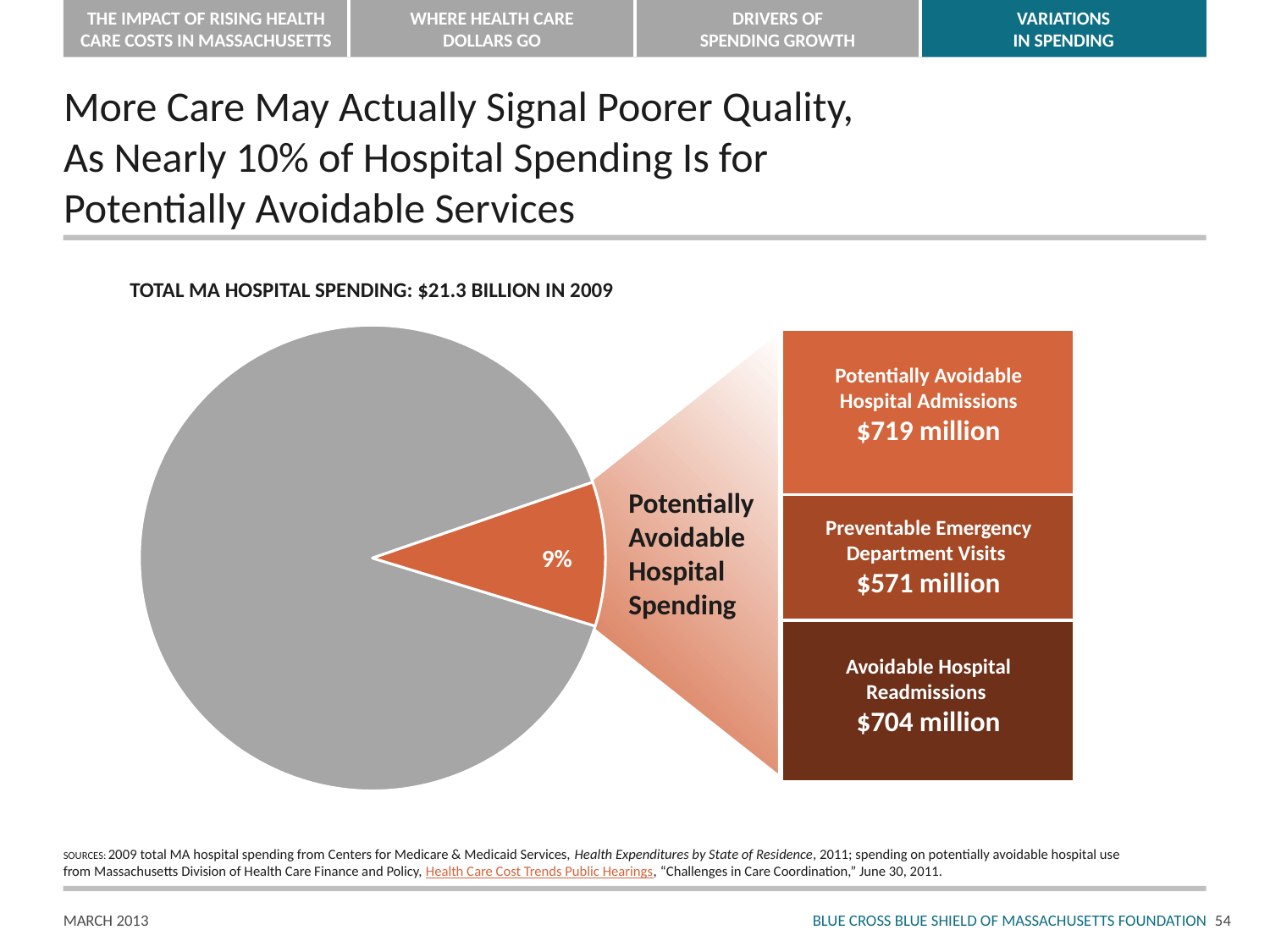
What is the value shown for Potentially Avoidable Hospital Admissions? $719 million What total MA hospital spending figure is stated in the chart heading? $21.3 billion in 2009 What is the value shown for Avoidable Hospital Readmissions? $704 million What is the value shown for Preventable Emergency Department Visits? $571 million What is the combined value of the three potentially avoidable hospital spending components? $1,994 million Which of the three components of potentially avoidable hospital spending has the highest value? Potentially Avoidable Hospital Admissions How many components of potentially avoidable hospital spending are broken out next to the pie chart? 3 Which is larger: Avoidable Hospital Readmissions or Preventable Emergency Department Visits? Avoidable Hospital Readmissions What share of total MA hospital spending does the Potentially Avoidable Hospital Spending slice represent? 9% What kind of chart is shown on the slide? Pie chart What is the difference between Potentially Avoidable Hospital Admissions and Preventable Emergency Department Visits? $148 million Which of the three components of potentially avoidable hospital spending has the lowest value? Preventable Emergency Department Visits